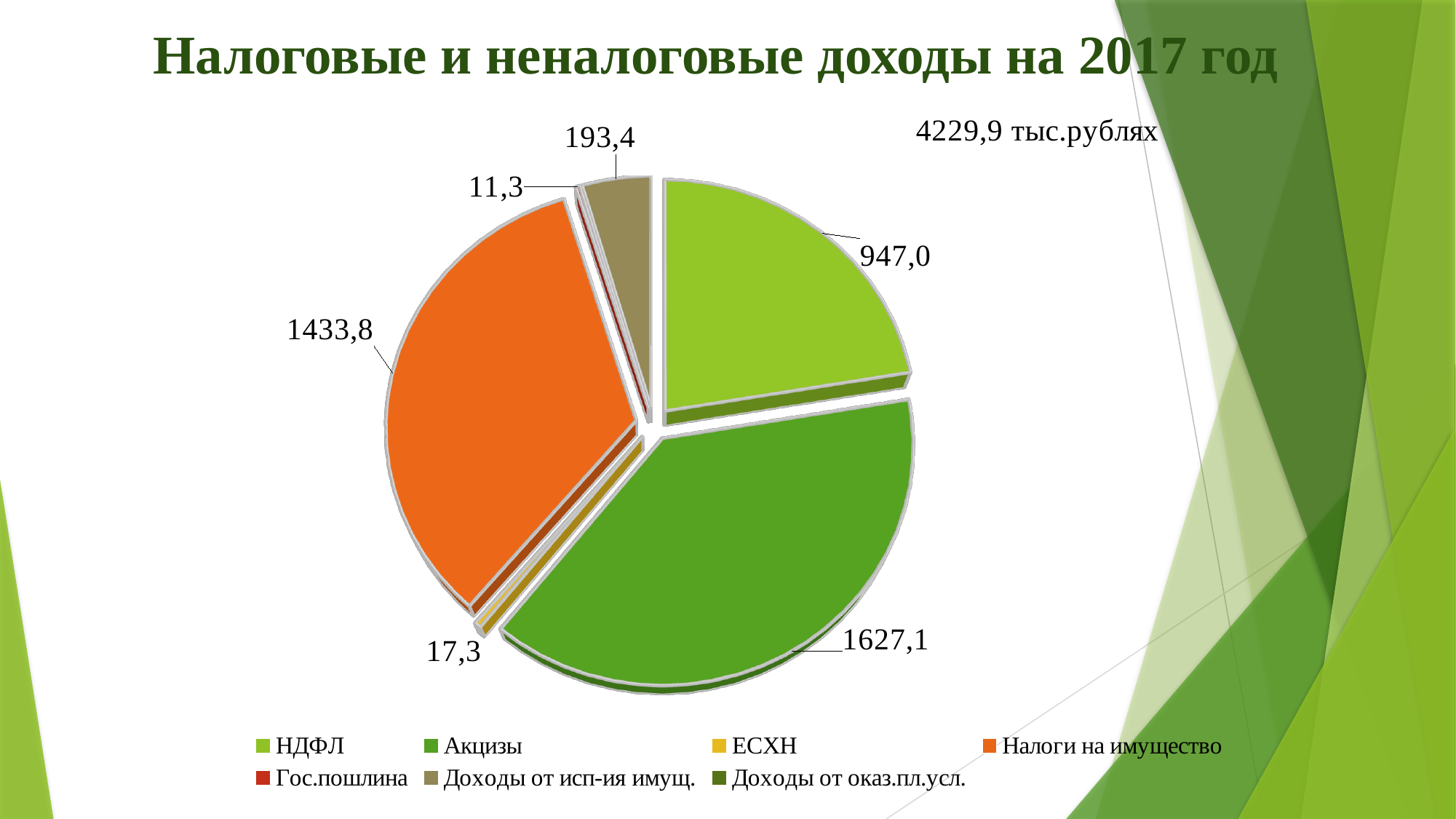
What is the value for Акцизы? 1627,1 What is the value for Доходы от исп-ия имущ.? 193,4 What is the difference between the values for Акцизы and Налоги на имущество? 193,3 How many entries does the legend list? 7 What is the value for ЕСХН? 17,3 What is the value for Гос.пошлина? 11,3 What type of chart is shown on the slide? pie chart What is the value for НДФЛ? 947,0 Which category has the largest slice of the pie? Акцизы What is the title of the chart? 4229,9 тыс.рублях Which is larger, Налоги на имущество or НДФЛ? Налоги на имущество What is the value for Налоги на имущество? 1433,8